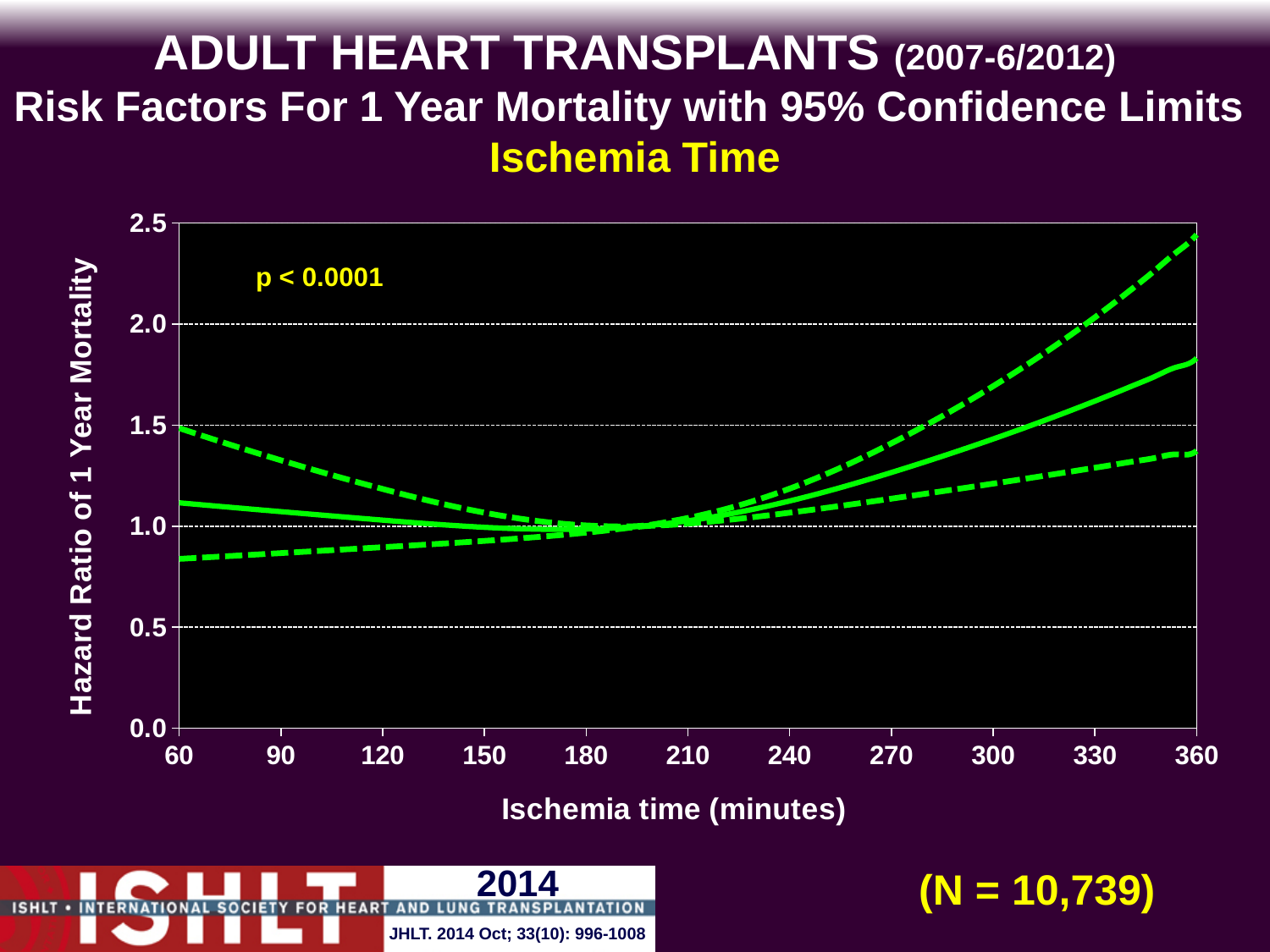
Does the upper dashed confidence limit rise or fall between ischemia times of 60 and 180 minutes? fall Does the solid hazard ratio line rise or fall between ischemia times of 240 and 360 minutes? rise Is the lower dashed confidence limit at an ischemia time of 360 minutes greater or less than 1.5? less Is the hazard ratio of the solid line at an ischemia time of 360 minutes greater or less than 1.5? greater Is the upper dashed confidence limit at an ischemia time of 60 minutes greater or less than 1.0? greater How many lines are plotted on the chart? 3 What is the title of the x axis? Ischemia time (minutes) What p-value is printed on the chart? p < 0.0001 What kind of chart is shown on the slide? line chart How many tick labels are shown on the x axis? 11